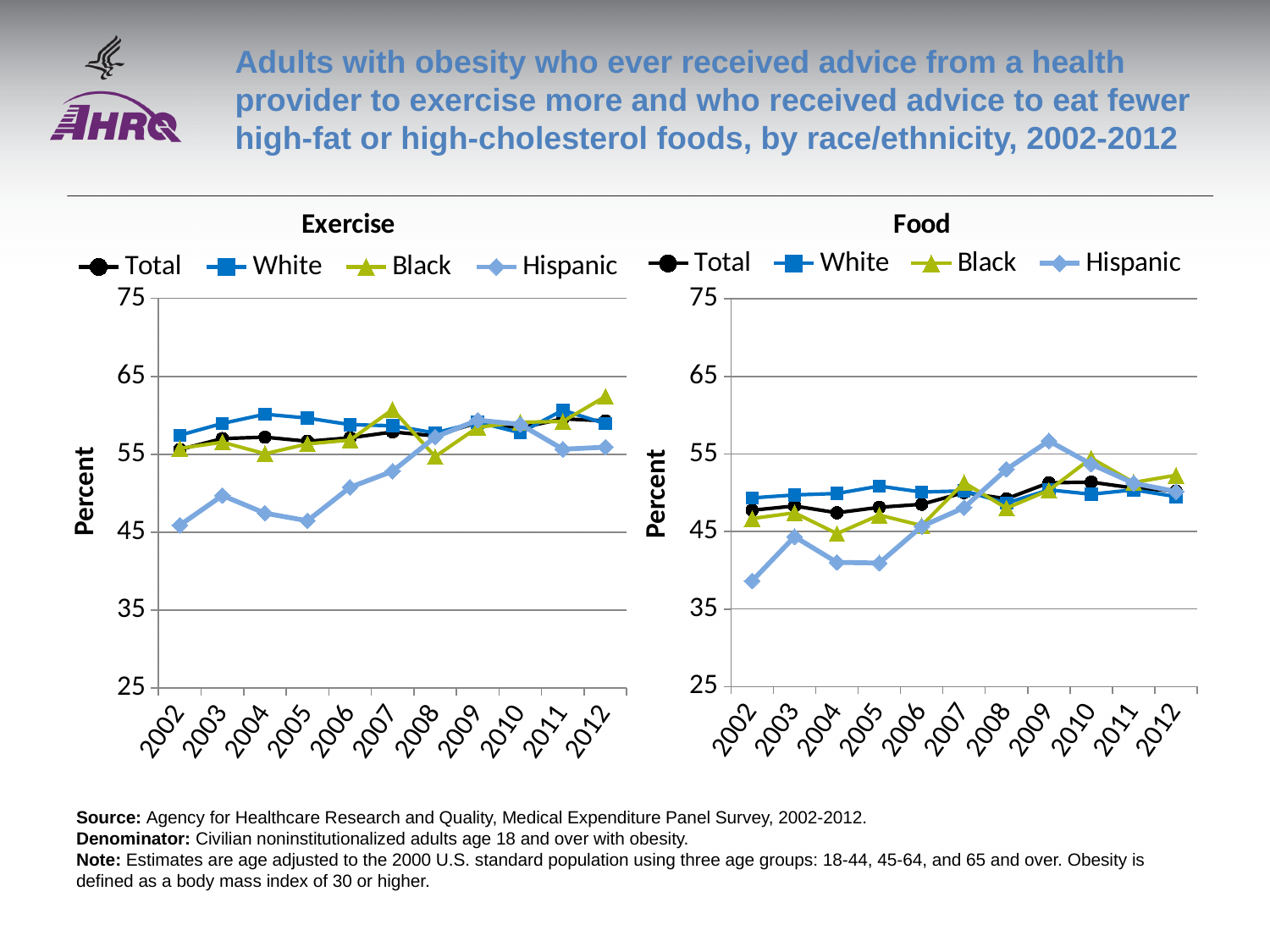
In the Food chart, which series has the lowest value in 2002? Hispanic How many years are plotted on the x axis of the Food chart? 11 How many series does the legend of the Exercise chart list? 4 What is the label on the y axis of the Food chart? Percent In the Exercise chart, does the Hispanic line rise or fall from 2002 to 2012? rise In the Exercise chart, is the value for Black in 2012 greater or less than 55? greater What kind of chart is the Exercise chart? line chart In the Exercise chart, which is larger in 2004, White or Hispanic? White In the Exercise chart, is the value for Hispanic in 2002 greater or less than 55? less In the Food chart, which series has the highest value in 2009? Hispanic In the Food chart, is the value for Hispanic in 2002 greater or less than 45? less In the Exercise chart, which series has the lowest value in 2002? Hispanic